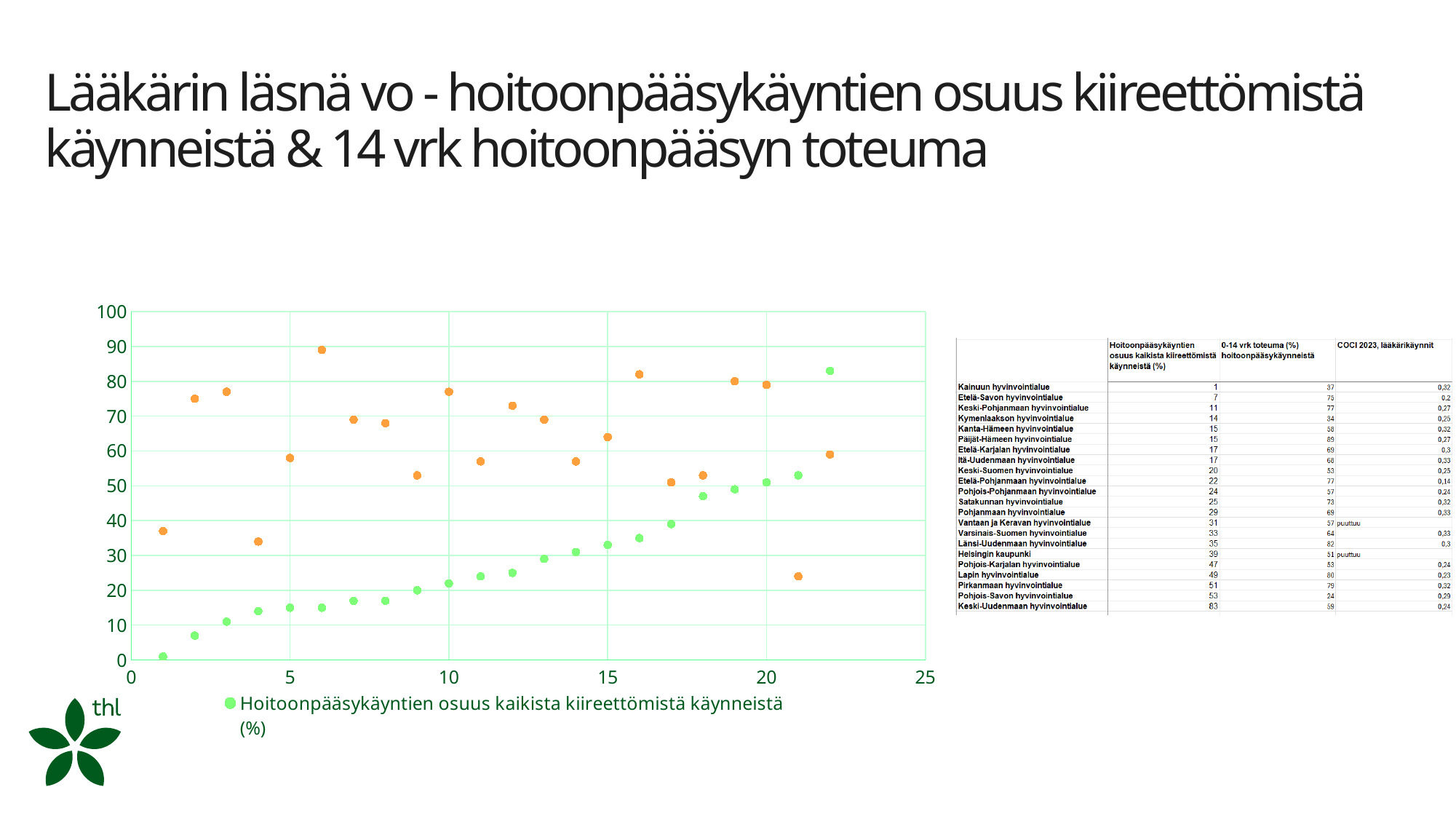
How many entries does the chart legend list? 1 What kind of chart is shown on the slide? Scatter chart Do the green points rise or fall as the x-axis value increases? Rise At x = 22, which point is higher, the orange one or the green one? Green Is the orange point at x = 21 greater or less than 30 on the y axis? less What is the maximum value shown on the chart's y axis? 100 What is the legend entry shown below the chart? Hoitoonpääsykäyntien osuus kaikista kiireettömistä käynneistä (%) How many green points are plotted on the chart? 22 Is the green point at x = 1 greater or less than 10 on the y axis? less Is the orange point at x = 6 greater or less than 80 on the y axis? greater At x = 10, which point is higher, the orange one or the green one? Orange